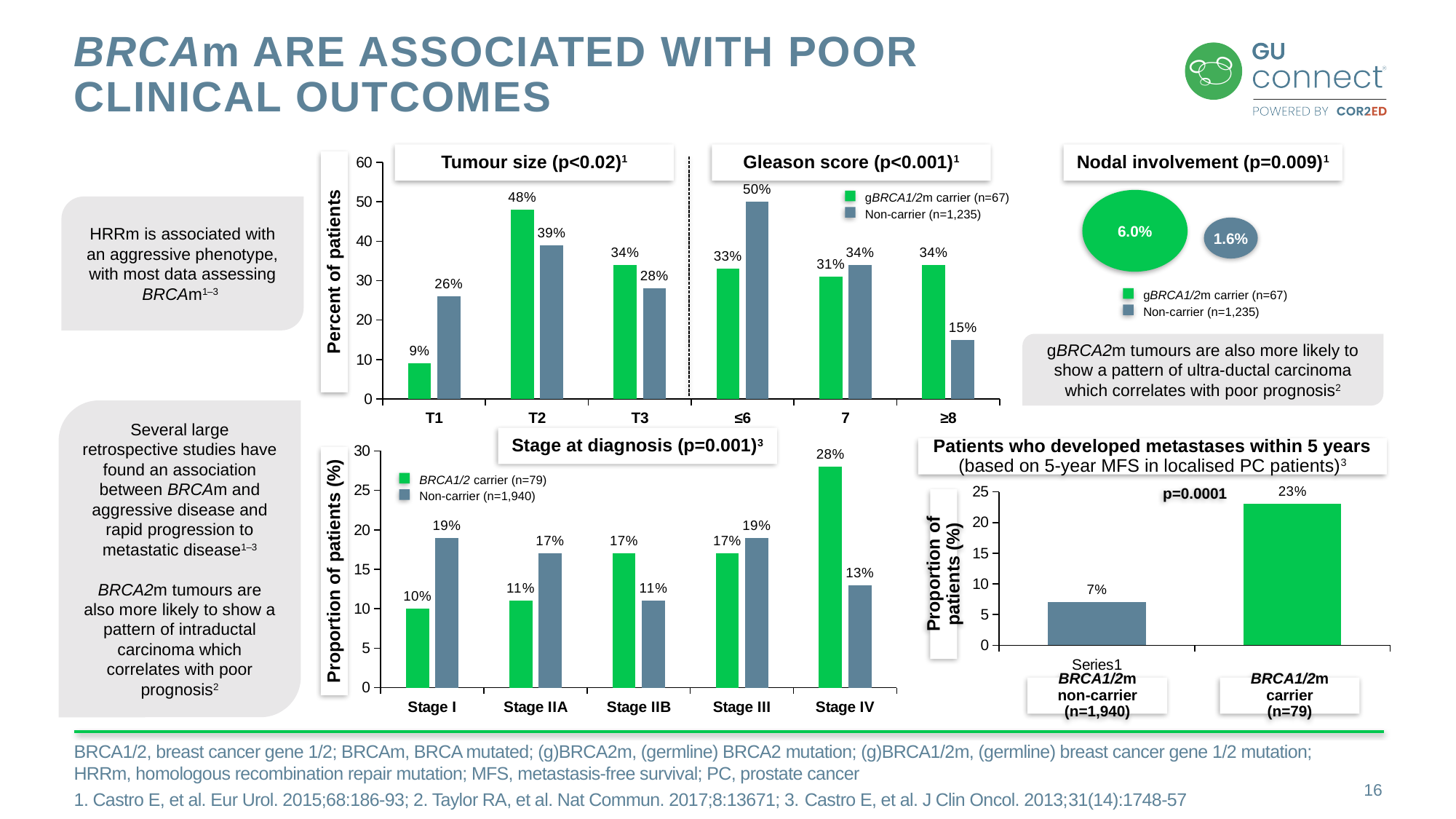
In the Patients who developed metastases within 5 years chart, what is the value for BRCA1/2m carriers? 23% In the Tumour size chart, what is the value for gBRCA1/2m carriers at T2? 48% In the Tumour size chart, which is larger at T3: the gBRCA1/2m carrier value or the non-carrier value? gBRCA1/2m carrier In the Tumour size chart, what is the value for non-carriers at T1? 26% What kind of chart is the Stage at diagnosis chart? Bar chart In the Gleason score chart, which category has the highest non-carrier value? ≤6 In the Stage at diagnosis chart, how many stage categories are shown on the x axis? 5 In the Stage at diagnosis chart, what is the difference between the non-carrier and BRCA1/2 carrier values at Stage I? 9% In the Nodal involvement chart, what is the value for gBRCA1/2m carriers? 6.0% In the Gleason score chart, what is the difference between the gBRCA1/2m carrier and non-carrier values at ≥8? 19% In the Stage at diagnosis chart, what is the value for BRCA1/2 carriers at Stage IV? 28% In the Gleason score chart, what is the value for non-carriers at ≥8? 15%